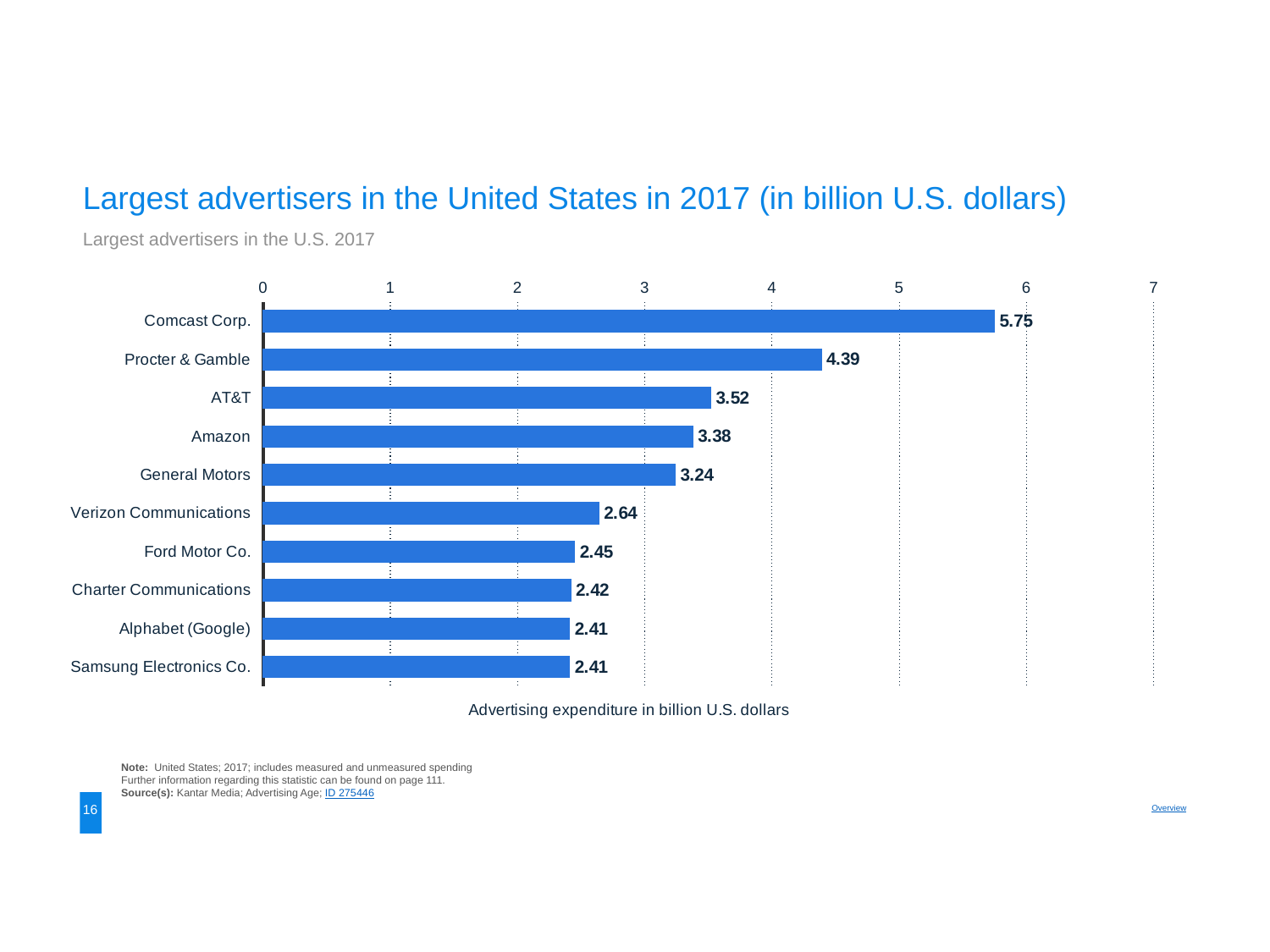
How many advertisers are shown in the chart? 10 What is the advertising expenditure for Amazon? 3.38 Which has a larger advertising expenditure, Procter & Gamble or AT&T? Procter & Gamble What is the label of the horizontal axis? Advertising expenditure in billion U.S. dollars What kind of chart is shown on the slide? Bar chart What is the difference in advertising expenditure between AT&T and General Motors? 0.28 Which advertiser has the highest advertising expenditure? Comcast Corp. Which has a larger advertising expenditure, Ford Motor Co. or General Motors? General Motors What is the difference in advertising expenditure between Comcast Corp. and Procter & Gamble? 1.36 What is the advertising expenditure for Comcast Corp.? 5.75 What is the advertising expenditure for Verizon Communications? 2.64 Is the value for Procter & Gamble greater or less than 4? greater